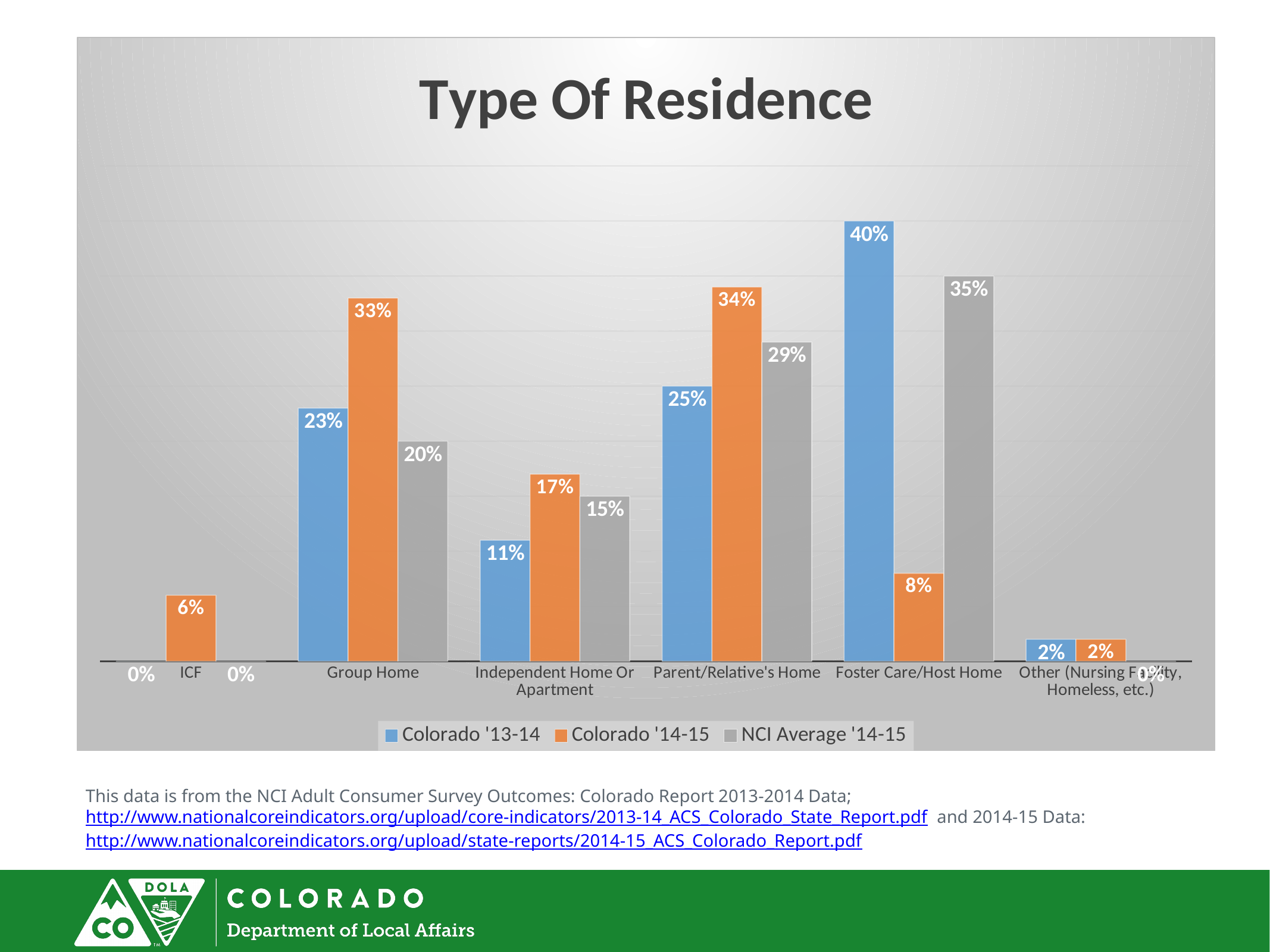
What is the difference between the Colorado '14-15 and NCI Average '14-15 values for Group Home? 13% What is the Colorado '14-15 value for ICF? 6% How many residence categories are shown on the x axis? 6 What is the NCI Average '14-15 value for Foster Care/Host Home? 35% Which category has the highest Colorado '13-14 value? Foster Care/Host Home How many series does the legend list? 3 What is the difference between the Colorado '13-14 and Colorado '14-15 values for Foster Care/Host Home? 32% What is the Colorado '13-14 value for Independent Home Or Apartment? 11% What is the Colorado '14-15 value for Group Home? 33% Which is larger for Parent/Relative's Home: the Colorado '13-14 value or the NCI Average '14-15 value? NCI Average '14-15 What kind of chart is shown on the slide? Bar chart Which category has the highest Colorado '14-15 value? Parent/Relative's Home